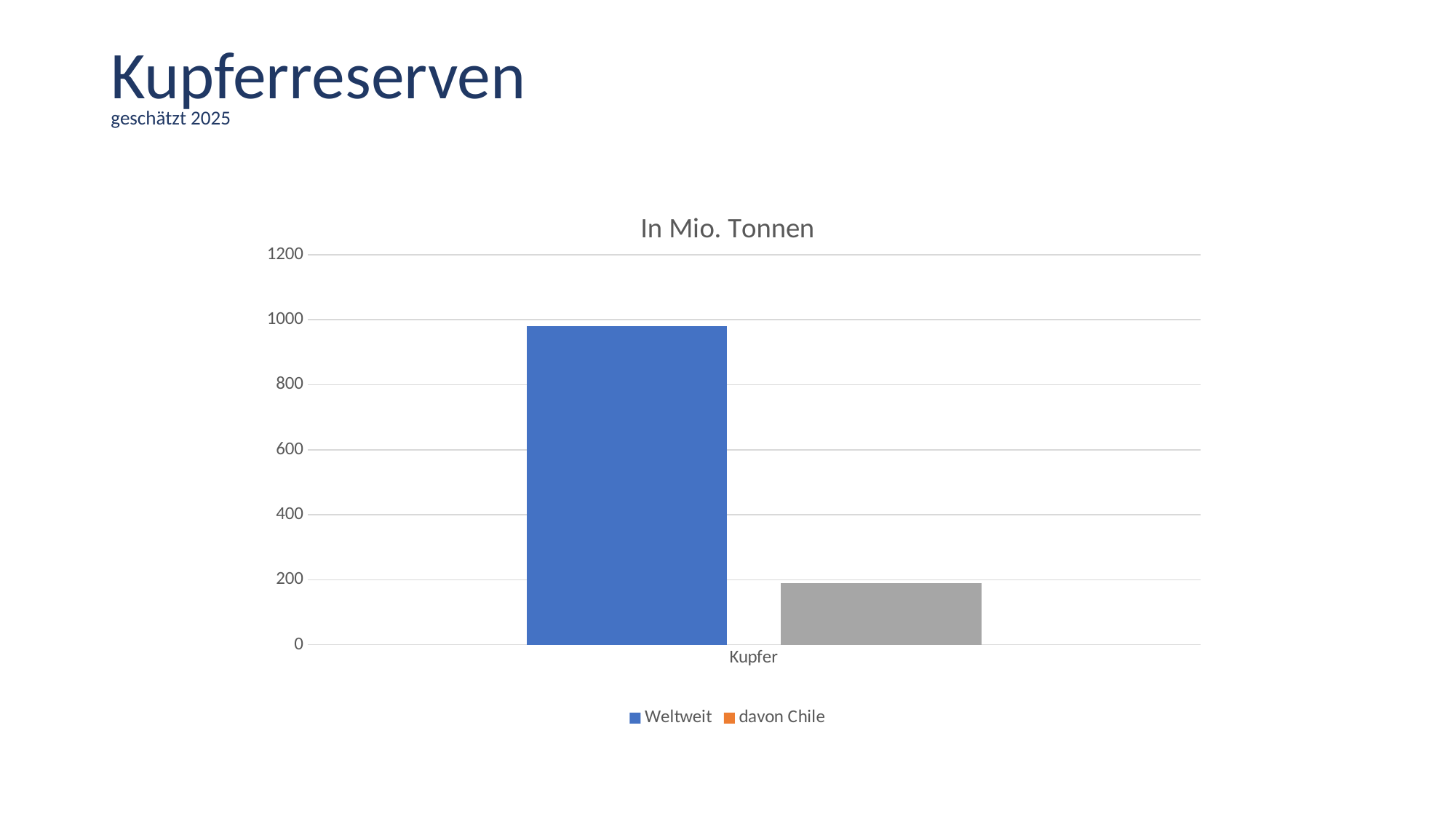
What is the name of the category on the x axis? Kupfer Is the value for davon Chile greater or less than 400? less How many categories are shown on the x axis? 1 Which series has the higher value for Kupfer, Weltweit or davon Chile? Weltweit What kind of chart is shown on the slide? bar chart Which series shows the lowest value? davon Chile What is the title of the chart? In Mio. Tonnen Is the value for Weltweit greater or less than 1000? less Is the value for Weltweit greater or less than 800? greater Which series shows the highest value? Weltweit How many series does the legend list? 2